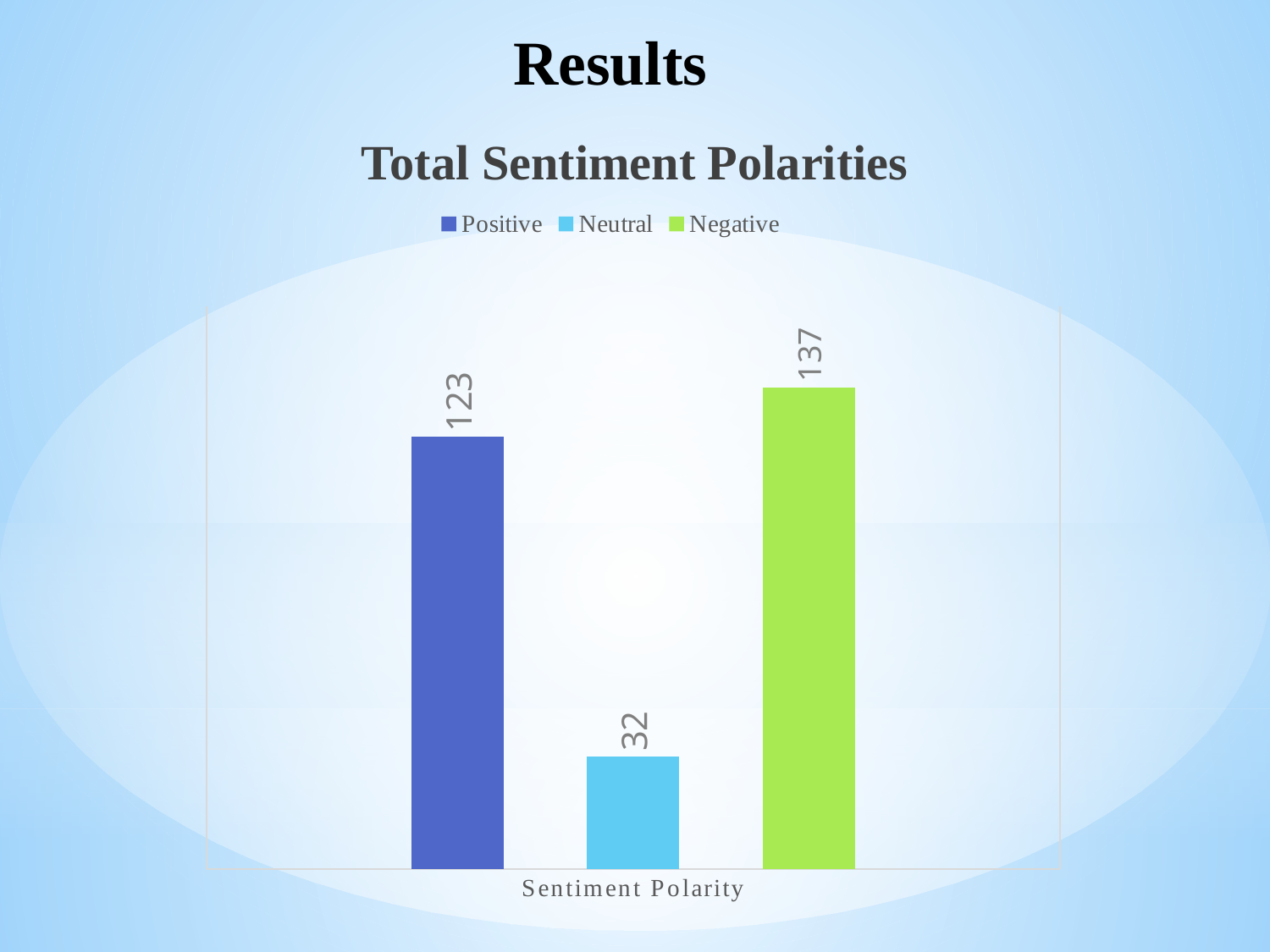
Which series has the lowest value? Neutral Which series has the highest value? Negative How many series does the legend list? 3 What is the value for Positive? 123 What is the difference between the Positive and Neutral values? 91 What is the label on the x axis? Sentiment Polarity What is the value for Negative? 137 What is the title of the chart? Total Sentiment Polarities What is the difference between the Negative and Positive values? 14 What is the value for Neutral? 32 What kind of chart is shown? Bar chart Which is larger, Positive or Negative? Negative